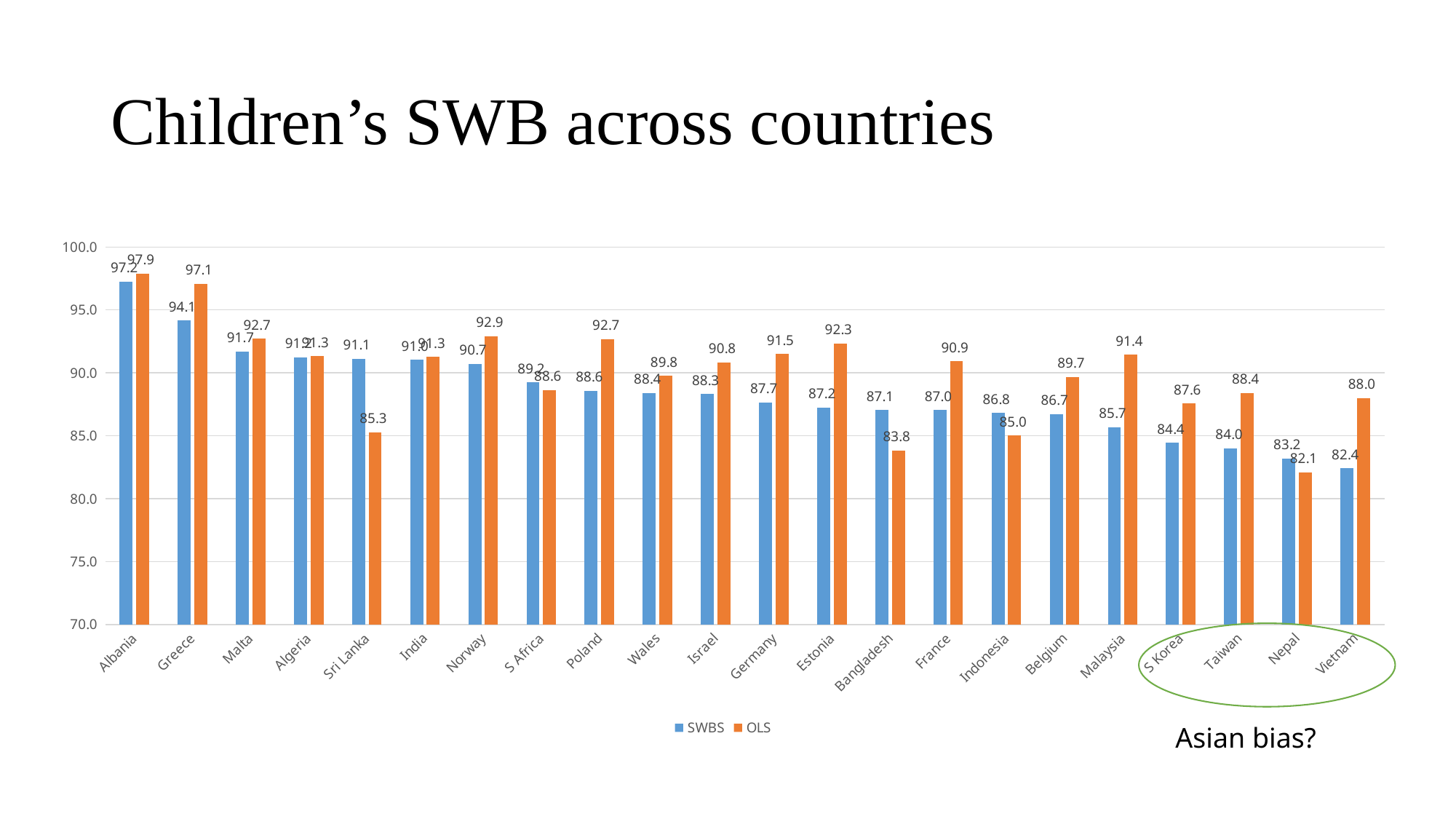
What kind of chart is shown on the slide? Bar chart Which country has the highest OLS value? Albania Which country has the lowest SWBS value? Vietnam Is the OLS value for Bangladesh greater or less than 85.0? less What is the difference between the SWBS and OLS values for Sri Lanka? 5.8 How many countries are shown on the x axis? 22 What is the OLS value for Vietnam? 88.0 For Malaysia, which is larger: the SWBS value or the OLS value? OLS How many series does the legend list? 2 What is the OLS value for Sri Lanka? 85.3 What is the SWBS value for Greece? 94.1 Which country has the lowest OLS value? Nepal